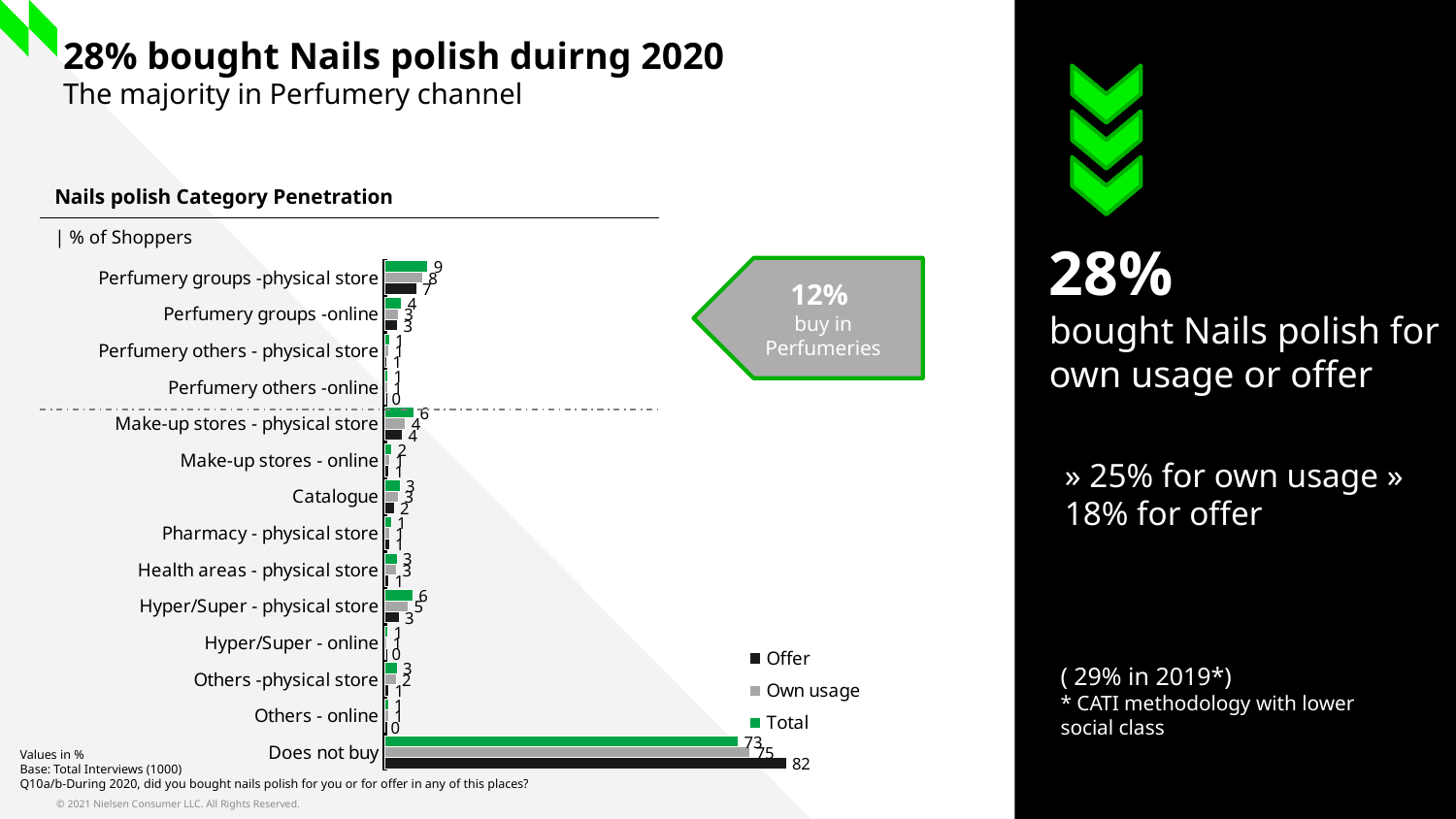
Among the purchase channels (excluding 'Does not buy'), which has the highest Total value? Perfumery groups - physical store What is the Own usage value for 'Hyper/Super - physical store'? 5 What kind of chart is the Nails polish Category Penetration chart? Bar chart What is the Total value for 'Perfumery groups - physical store'? 9 Which has a larger Total value: 'Make-up stores - physical store' or 'Perfumery groups - online'? Make-up stores - physical store How many series does the legend of the chart list? 3 What is the difference between the Offer value and the Total value for 'Does not buy'? 9 What is the Own usage value for 'Does not buy'? 75 How many categories are shown on the y axis of the Nails polish Category Penetration chart? 14 What is the Total value for 'Does not buy' in the Nails polish Category Penetration chart? 73 What is the Offer value for 'Does not buy' in the Nails polish Category Penetration chart? 82 Which category has the highest Total value in the chart? Does not buy